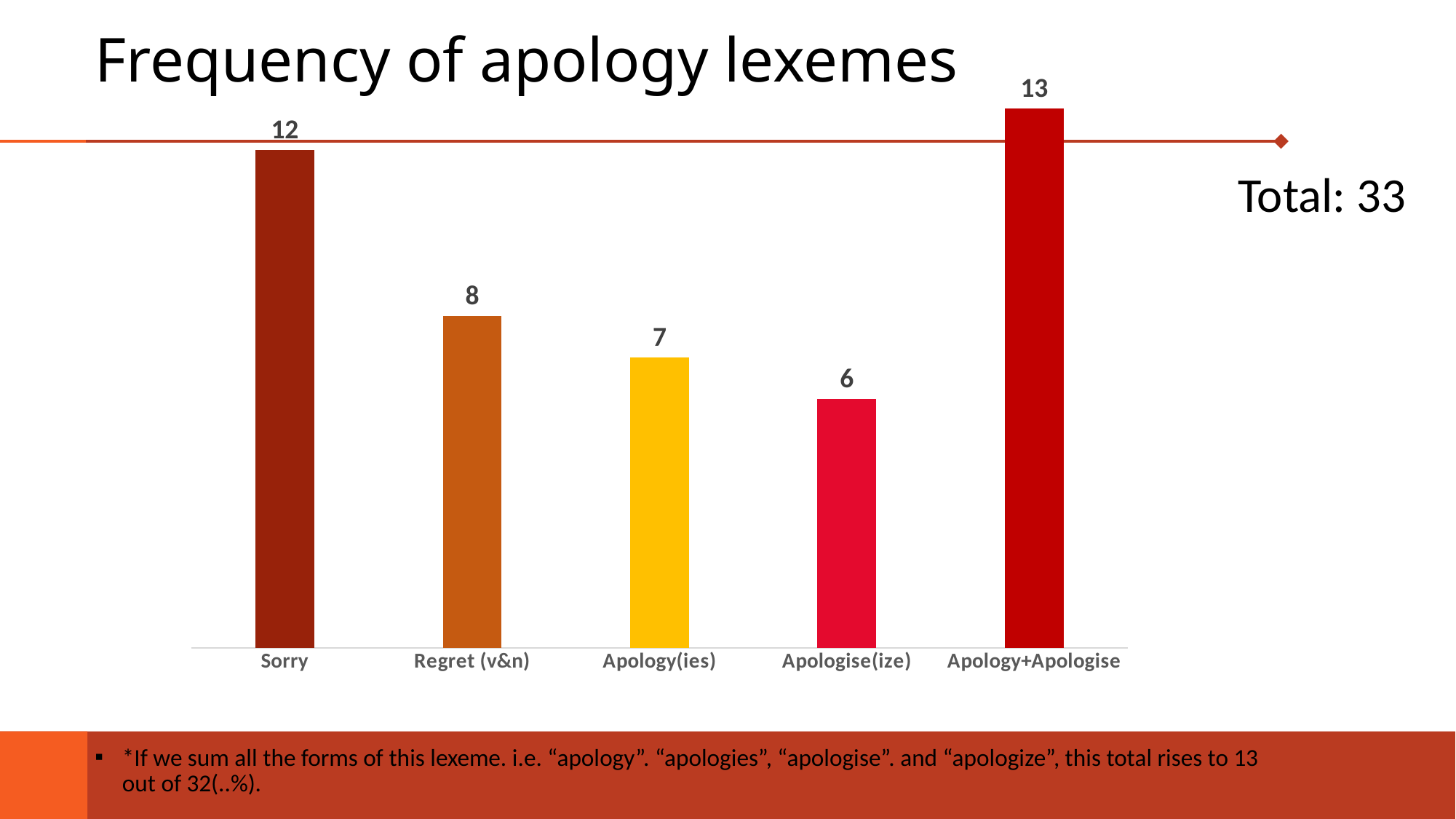
What is the value for Apologise(ize)? 6 What kind of chart is shown on the slide? bar chart What colour is the bar for Apology(ies)? yellow How many categories are shown on the x axis? 5 What is the title of the slide? Frequency of apology lexemes Which is larger, the value for Sorry or the value for Apology+Apologise? Apology+Apologise What is the value for Regret (v&n)? 8 Which category has the lowest value? Apologise(ize) Which category has the highest value? Apology+Apologise What is the difference between the values for Apology(ies) and Apologise(ize)? 1 What is the value for Sorry? 12 What is the difference between the values for Sorry and Regret (v&n)? 4